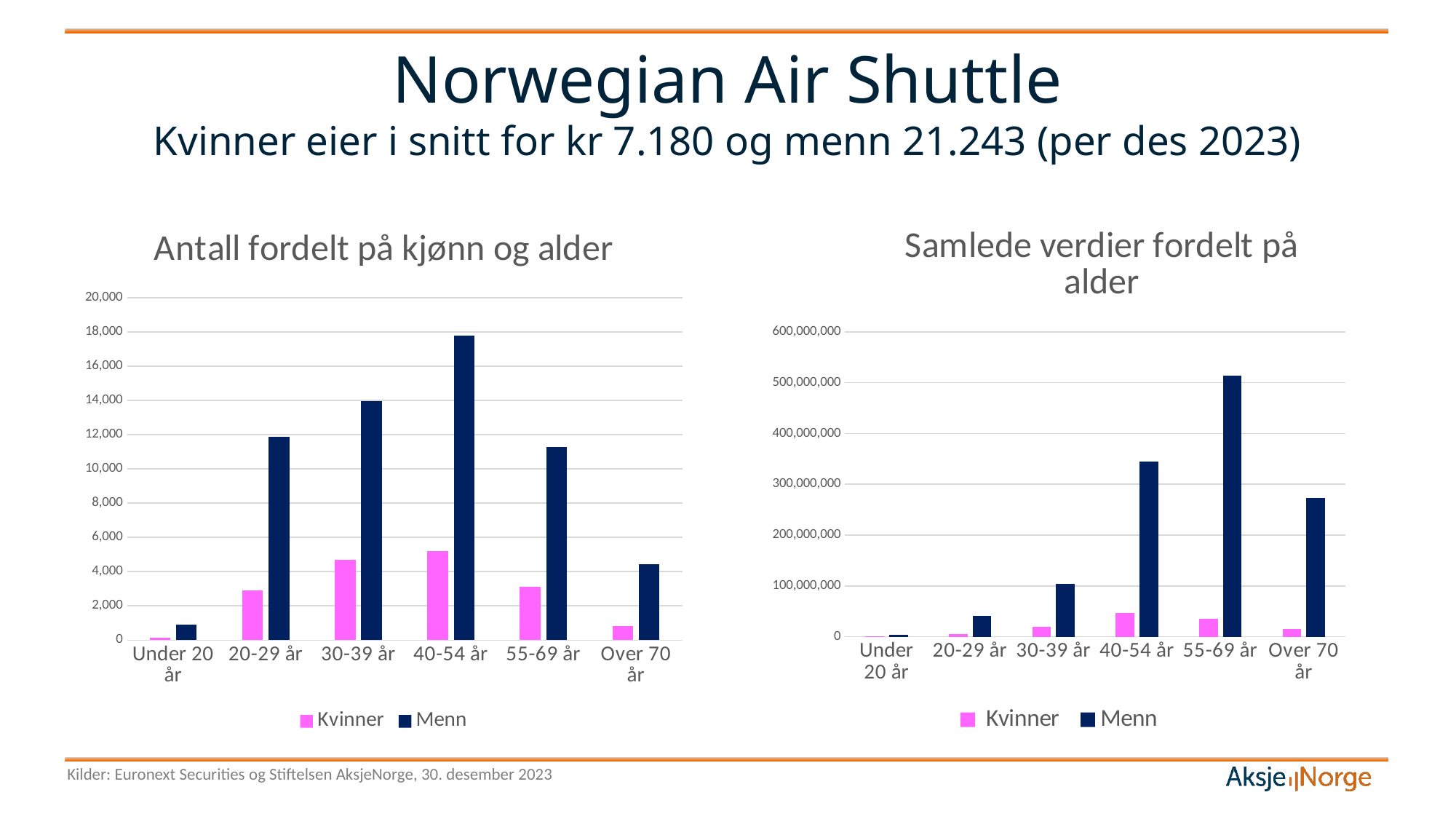
In the right chart "Samlede verdier fordelt på alder", which age category has the highest value for Menn? 55-69 år Which colour represents the Kvinner series in the legends of both charts? pink In the left chart "Antall fordelt på kjønn og alder", which age category has the lowest value for Kvinner? Under 20 år In the left chart "Antall fordelt på kjønn og alder", is the value for Kvinner in the 30-39 år category greater or less than 4,000? greater In the right chart "Samlede verdier fordelt på alder", is the value for Menn in the Over 70 år category greater or less than 300,000,000? less In the right chart "Samlede verdier fordelt på alder", which age category has the lowest value for Menn? Under 20 år How many age categories are shown on the x axis of the left chart "Antall fordelt på kjønn og alder"? 6 How many series does the legend of the right chart "Samlede verdier fordelt på alder" list? 2 In the left chart "Antall fordelt på kjønn og alder", which age category has the highest value for Menn? 40-54 år What kind of chart is the left chart titled "Antall fordelt på kjønn og alder"? bar chart In the left chart "Antall fordelt på kjønn og alder", is the value for Menn in the 40-54 år category greater or less than 16,000? greater In the right chart "Samlede verdier fordelt på alder", which is larger for Menn: the 40-54 år category or the 55-69 år category? 55-69 år